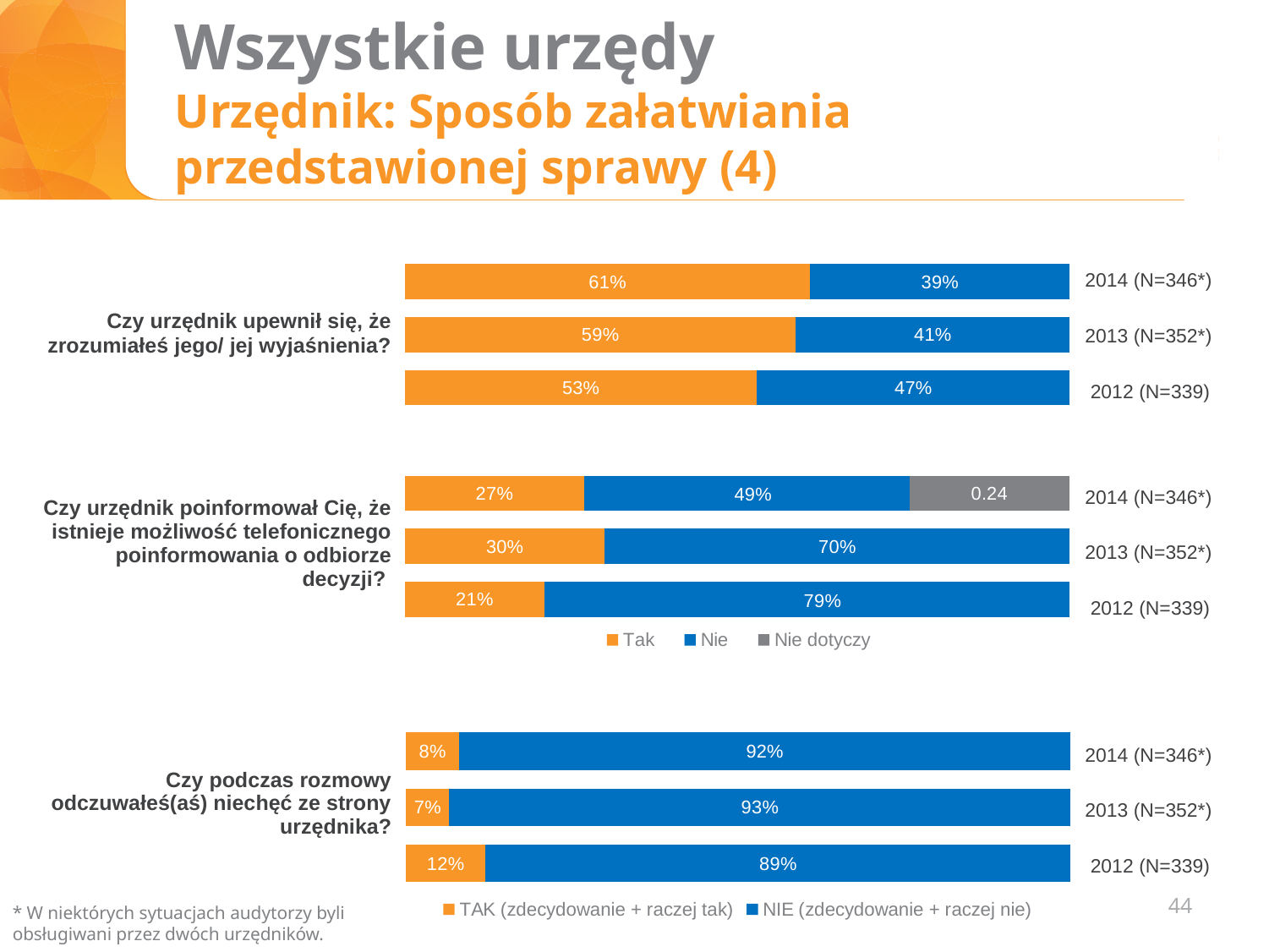
In the chart for "Czy urzędnik upewnił się, że zrozumiałeś jego/ jej wyjaśnienia?", what is the Nie value for 2012 (N=339)? 47% In the chart for "Czy urzędnik upewnił się, że zrozumiałeś jego/ jej wyjaśnienia?", what is the Tak value for 2014 (N=346*)? 61% How many series does the legend list for the chart "Czy urzędnik poinformował Cię, że istnieje możliwość telefonicznego poinformowania o odbiorze decyzji?"? 3 In the chart for "Czy urzędnik poinformował Cię, że istnieje możliwość telefonicznego poinformowania o odbiorze decyzji?", which year has the lowest Tak value? 2012 (N=339) How many years (bars) are shown in the chart for "Czy podczas rozmowy odczuwałeś(aś) niechęć ze strony urzędnika?"? 3 In the chart for "Czy urzędnik poinformował Cię, że istnieje możliwość telefonicznego poinformowania o odbiorze decyzji?", what is the Nie dotyczy value shown for 2014 (N=346*)? 0.24 What type of chart is used for "Czy podczas rozmowy odczuwałeś(aś) niechęć ze strony urzędnika?"? Stacked horizontal bar chart In the chart for "Czy urzędnik upewnił się, że zrozumiałeś jego/ jej wyjaśnienia?", which year has the highest Tak value? 2014 (N=346*) In the chart for "Czy urzędnik poinformował Cię, że istnieje możliwość telefonicznego poinformowania o odbiorze decyzji?", what is the Nie value for 2013 (N=352*)? 70% In the chart for "Czy urzędnik upewnił się, że zrozumiałeś jego/ jej wyjaśnienia?", what is the difference between the Tak values for 2014 and 2012? 8 percentage points In the chart for "Czy podczas rozmowy odczuwałeś(aś) niechęć ze strony urzędnika?", what is the TAK value for 2012 (N=339)? 12% In the chart for "Czy podczas rozmowy odczuwałeś(aś) niechęć ze strony urzędnika?", which is larger: the NIE value for 2013 or the NIE value for 2012? 2013 (93%)